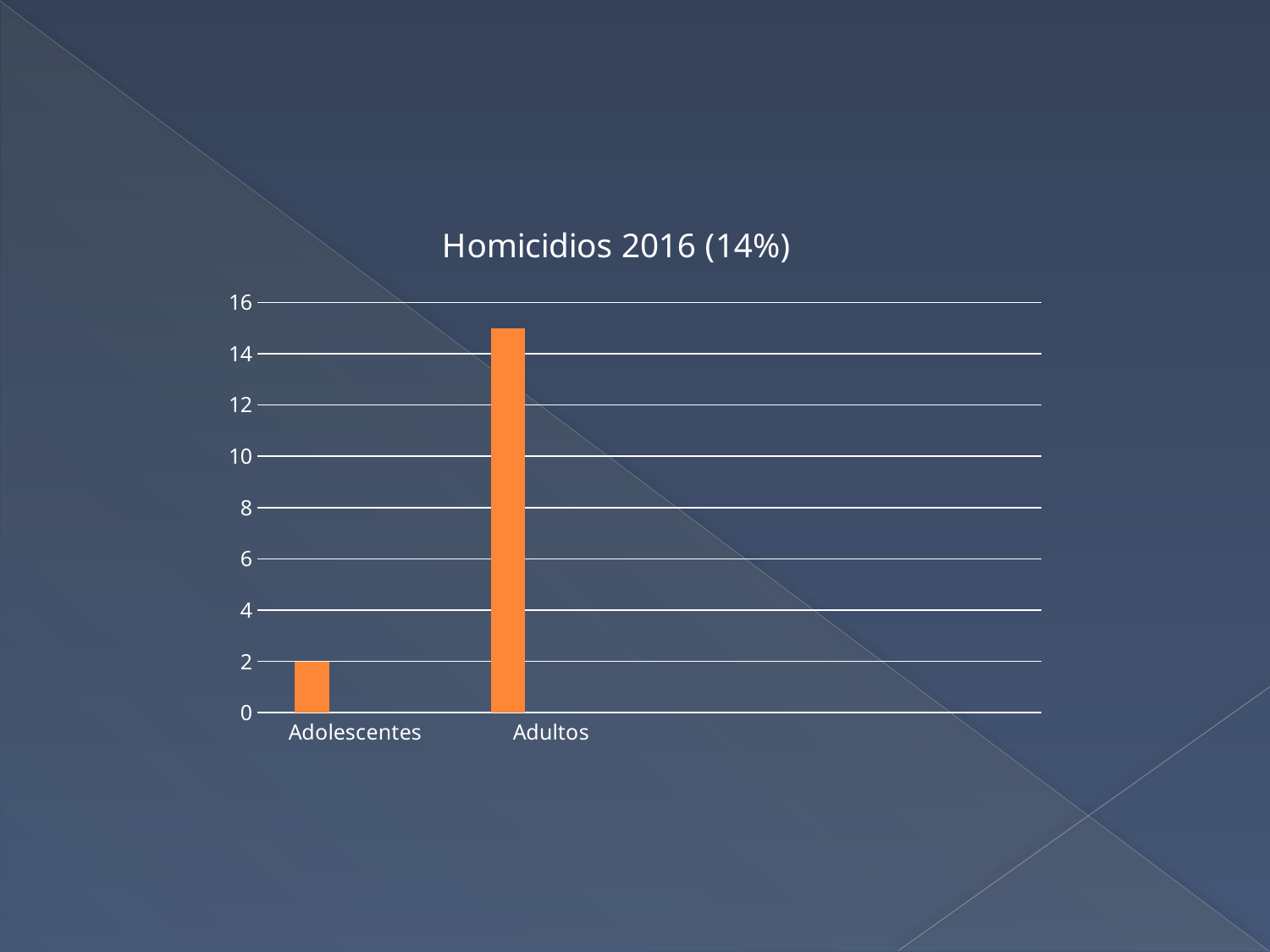
How many categories are shown on the x axis of the chart? 2 What is the value for Adolescentes? 2 Is the value for Adultos greater or less than 16? less What is the title of the chart? Homicidios 2016 (14%) Is the value for Adolescentes greater or less than 4? less Which category has the highest value in the chart? Adultos What kind of chart is shown on the slide? bar chart Which category has the lowest value in the chart? Adolescentes Is the value for Adultos greater or less than 14? greater What colour are the bars in the chart? orange What is the highest value shown on the y axis of the chart? 16 Which is larger, the value for Adolescentes or the value for Adultos? Adultos